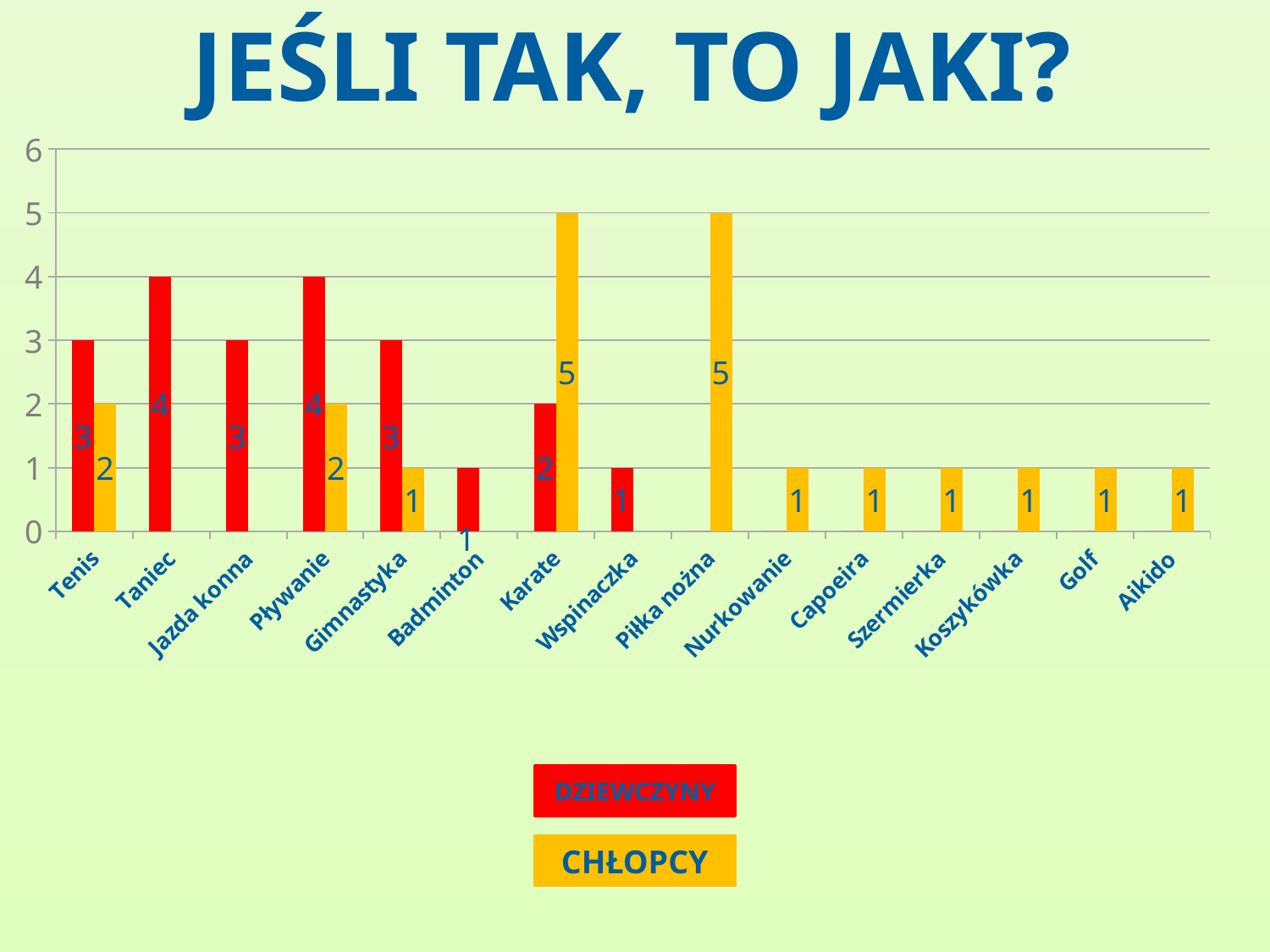
Which is larger in the Pływanie category: the DZIEWCZYNY value or the CHŁOPCY value? DZIEWCZYNY Which is larger: the DZIEWCZYNY value for Taniec or the DZIEWCZYNY value for Badminton? Taniec What is the value for CHŁOPCY in the Piłka nożna category? 5 What is the value for CHŁOPCY in the Gimnastyka category? 1 What type of chart is shown on the slide? bar chart What is the value for DZIEWCZYNY (girls) in the Tenis category? 3 What is the value for DZIEWCZYNY in the Pływanie category? 4 How many series does the legend list? 2 What is the difference between the DZIEWCZYNY and CHŁOPCY values in the Karate category? 3 What is the difference between the DZIEWCZYNY and CHŁOPCY values in the Tenis category? 1 What is the value for CHŁOPCY (boys) in the Karate category? 5 How many categories are shown on the x axis of the chart? 15